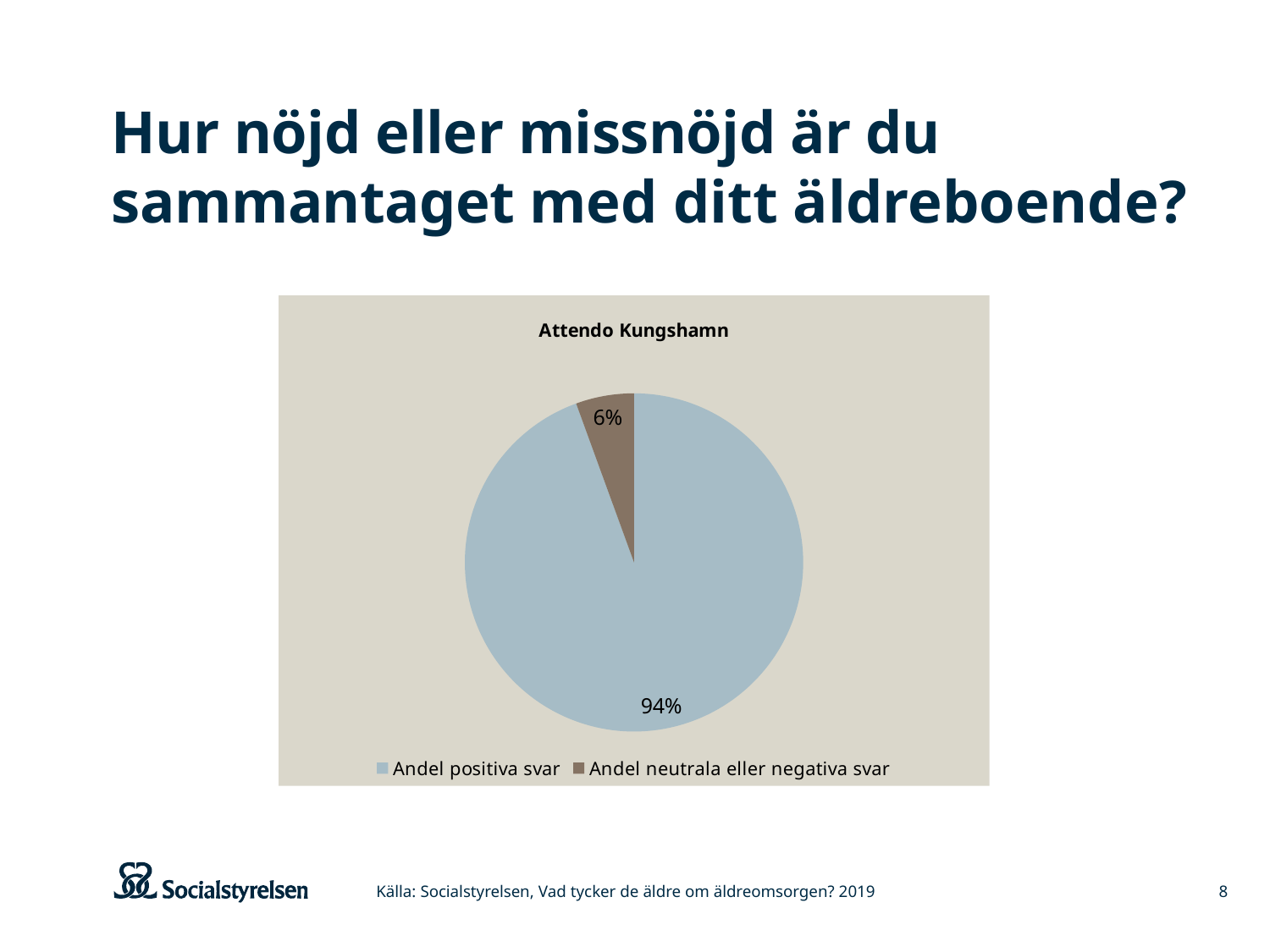
What is the title of the chart? Attendo Kungshamn What kind of chart is shown on the slide? Pie chart What share of the pie is 'Andel neutrala eller negativa svar'? 6% Which is larger, 'Andel positiva svar' or 'Andel neutrala eller negativa svar'? Andel positiva svar What colour is the 'Andel neutrala eller negativa svar' slice? Brown Which slice of the pie is the largest? Andel positiva svar How many entries does the legend list? 2 What is the total of the two slices shown in the pie chart? 100% What is the difference in percentage points between 'Andel positiva svar' and 'Andel neutrala eller negativa svar'? 88 percentage points What share of the pie is 'Andel positiva svar'? 94% How many slices does the pie chart have? 2 Which slice of the pie is the smallest? Andel neutrala eller negativa svar